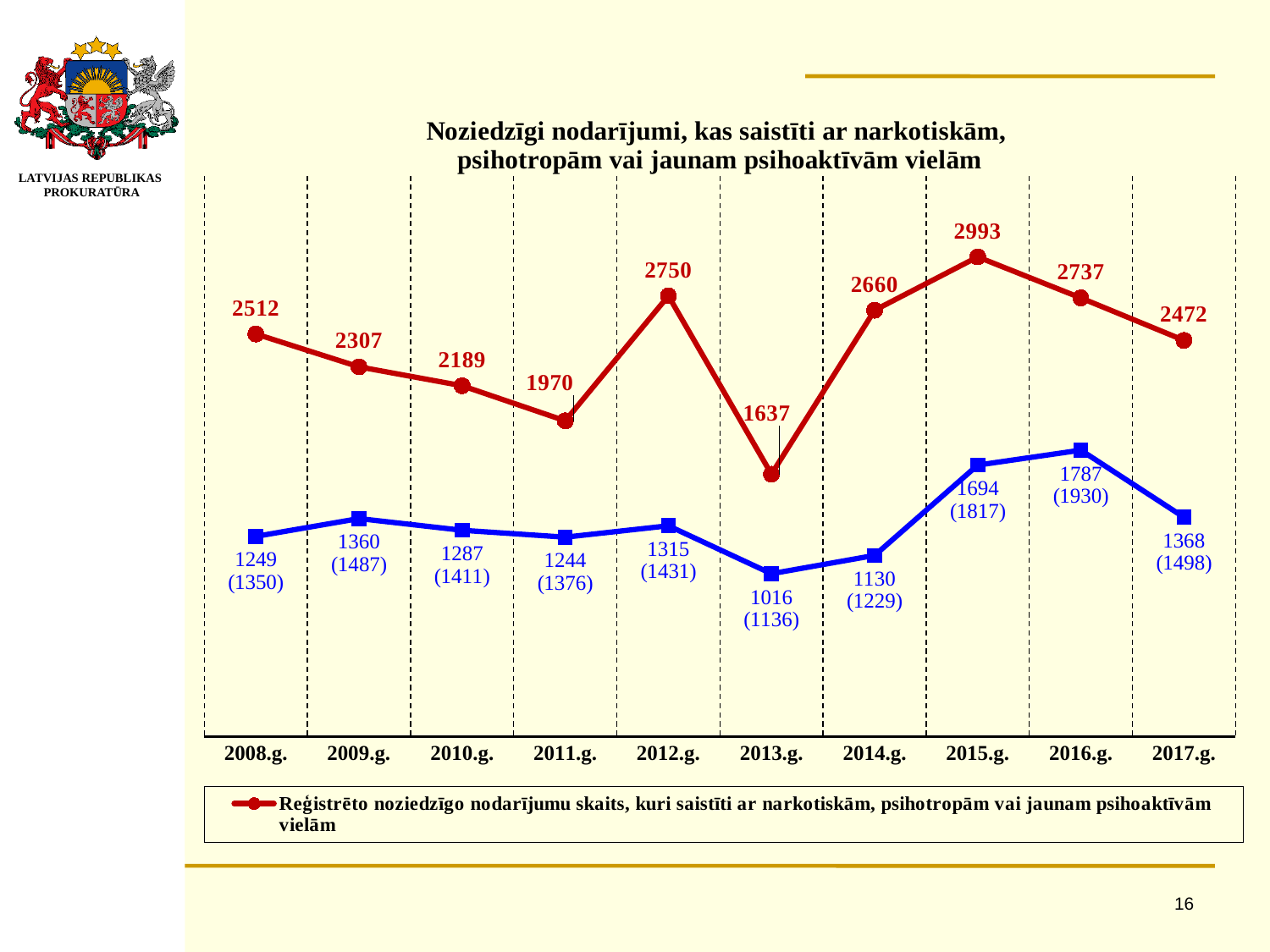
What kind of chart is shown on the slide? Line chart What is the main (non-parenthesised) value of the blue series for 2016.g.? 1787 What is the difference between the red series values for 2015.g. and 2013.g.? 1356 How many series does the legend list? 1 In which year does the red series reach its lowest value? 2013.g. Does the red series rise or fall from 2008.g. to 2011.g.? Fall Which year has the larger red series value, 2012.g. or 2014.g.? 2012.g. How many years are shown on the x axis? 10 In which year does the red series reach its highest value? 2015.g. In which year does the blue series have its lowest value? 2013.g. What is the value of the red series (registered drug-related crimes) for 2015.g.? 2993 What is the value of the red series for 2013.g.? 1637